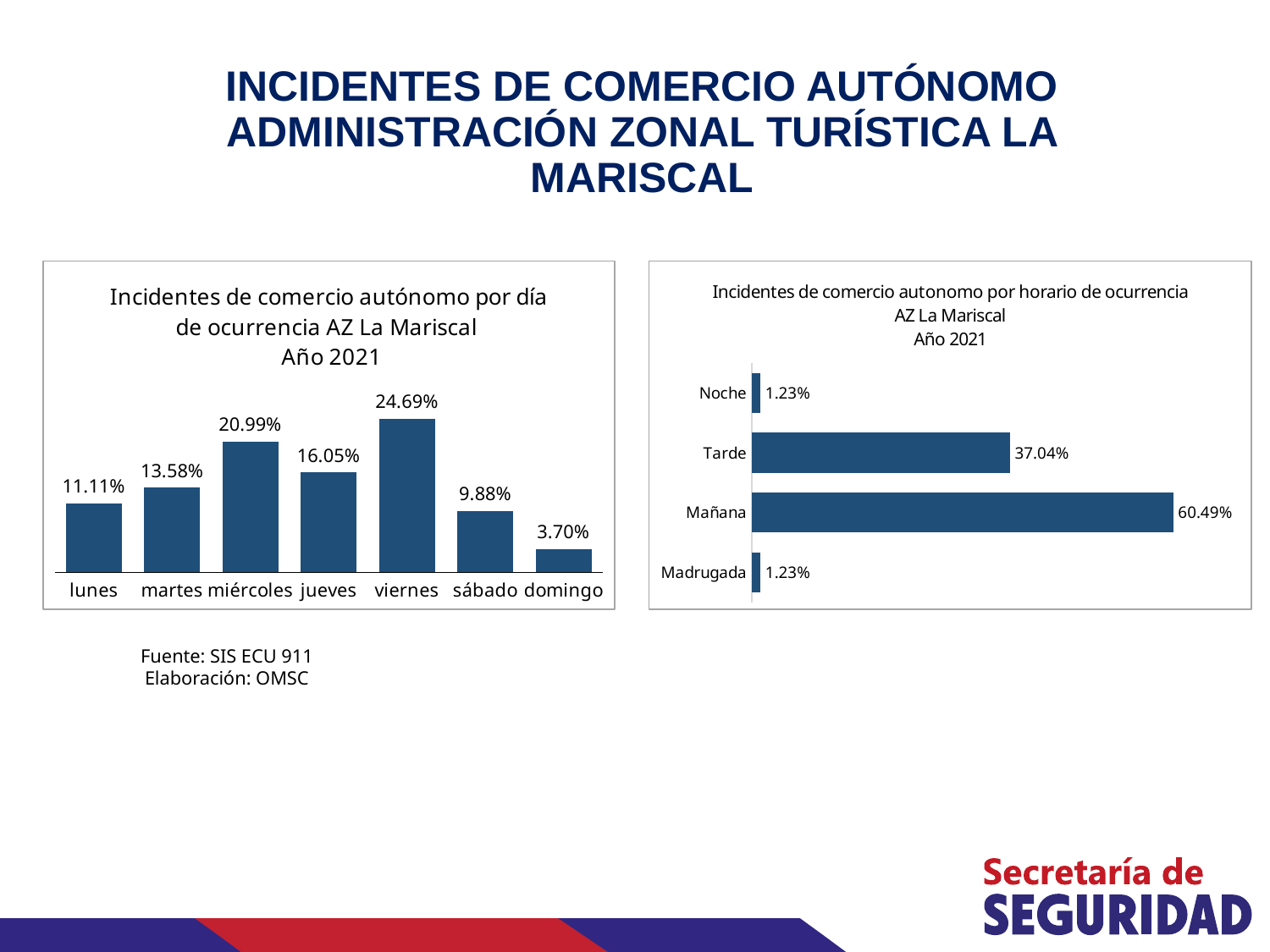
In the left chart (Incidentes de comercio autónomo por día de ocurrencia), what is the difference between miércoles and jueves? 4.94% In the left chart (Incidentes de comercio autónomo por día de ocurrencia), what is the value for martes? 13.58% In the left chart (Incidentes de comercio autónomo por día de ocurrencia), which is larger, lunes or sábado? lunes In the right chart (Incidentes de comercio autonomo por horario de ocurrencia), what is the value for Tarde? 37.04% In the right chart (Incidentes de comercio autonomo por horario de ocurrencia), which time period has the highest value? Mañana In the left chart (Incidentes de comercio autónomo por día de ocurrencia), which day has the lowest value? domingo What kind of chart is the right chart (Incidentes de comercio autonomo por horario de ocurrencia)? Bar chart In the left chart (Incidentes de comercio autónomo por día de ocurrencia), which day has the highest value? viernes In the left chart (Incidentes de comercio autónomo por día de ocurrencia), what is the value for viernes? 24.69% In the left chart (Incidentes de comercio autónomo por día de ocurrencia), how many days are shown? 7 In the right chart (Incidentes de comercio autonomo por horario de ocurrencia), what is the difference between Mañana and Tarde? 23.45% In the right chart (Incidentes de comercio autonomo por horario de ocurrencia), what is the value for Mañana? 60.49%